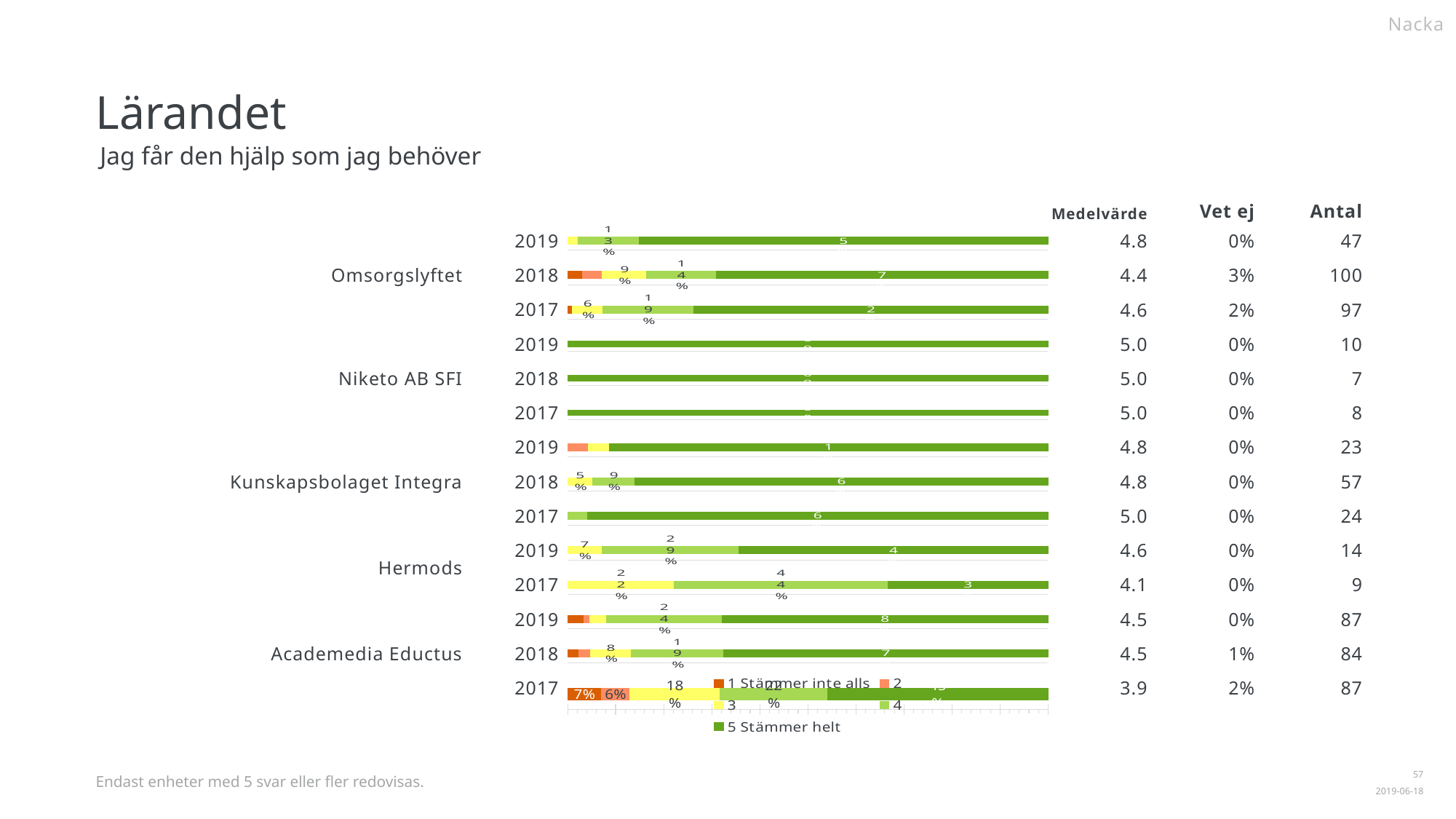
What is the Medelvärde for Academedia Eductus in 2017? 3.9 What is the difference in Antal between Academedia Eductus 2019 and Academedia Eductus 2018? 3 What is the Vet ej value for Omsorgslyftet in 2018? 3% Which unit-year row has the lowest Medelvärde? Academedia Eductus 2017 What kind of chart is shown on the slide? stacked bar chart What percentage of Academedia Eductus respondents in 2017 answered '1 Stämmer inte alls'? 7% How many series does the chart legend list? 5 How many bars (unit-year rows) are plotted in the chart? 14 What is the Medelvärde for Hermods in 2017? 4.1 What is the Medelvärde for Omsorgslyftet in 2019? 4.8 Which legend entry is shown in dark green? 5 Stämmer helt What is the Antal for Omsorgslyftet in 2018? 100